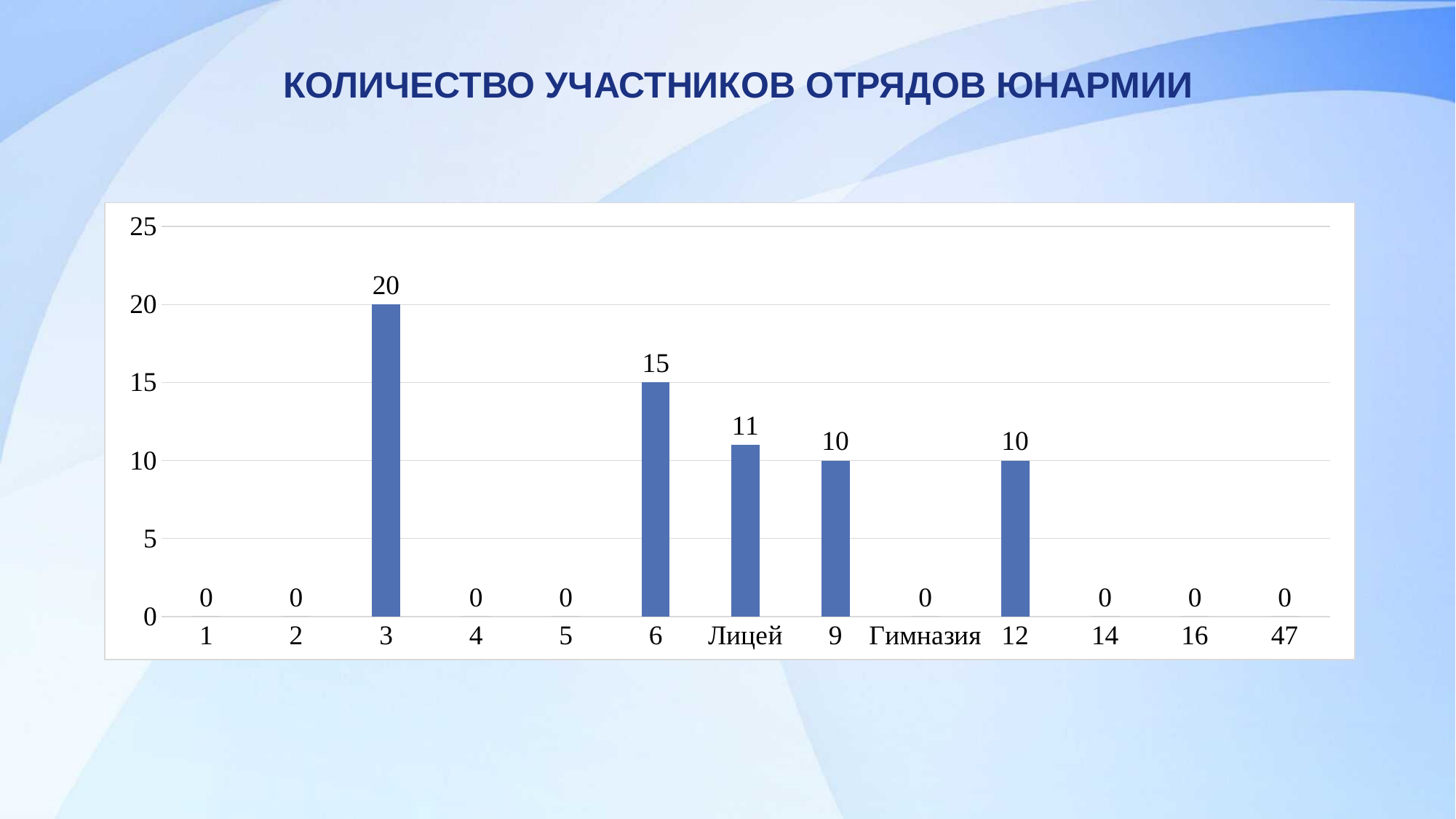
Which is larger, the value for category 6 or the value for Лицей? category 6 What is the difference between the values for category 3 and category 6? 5 How many categories are shown on the x axis? 13 What is the value for Гимназия? 0 What is the title of the chart on the slide? КОЛИЧЕСТВО УЧАСТНИКОВ ОТРЯДОВ ЮНАРМИИ How many categories have a value of 0? 8 What is the difference between the values for Лицей and category 9? 1 Which category has the highest value? 3 What kind of chart is shown on the slide? bar chart What is the value for category 6? 15 What is the value for category 3? 20 What is the value for Лицей? 11